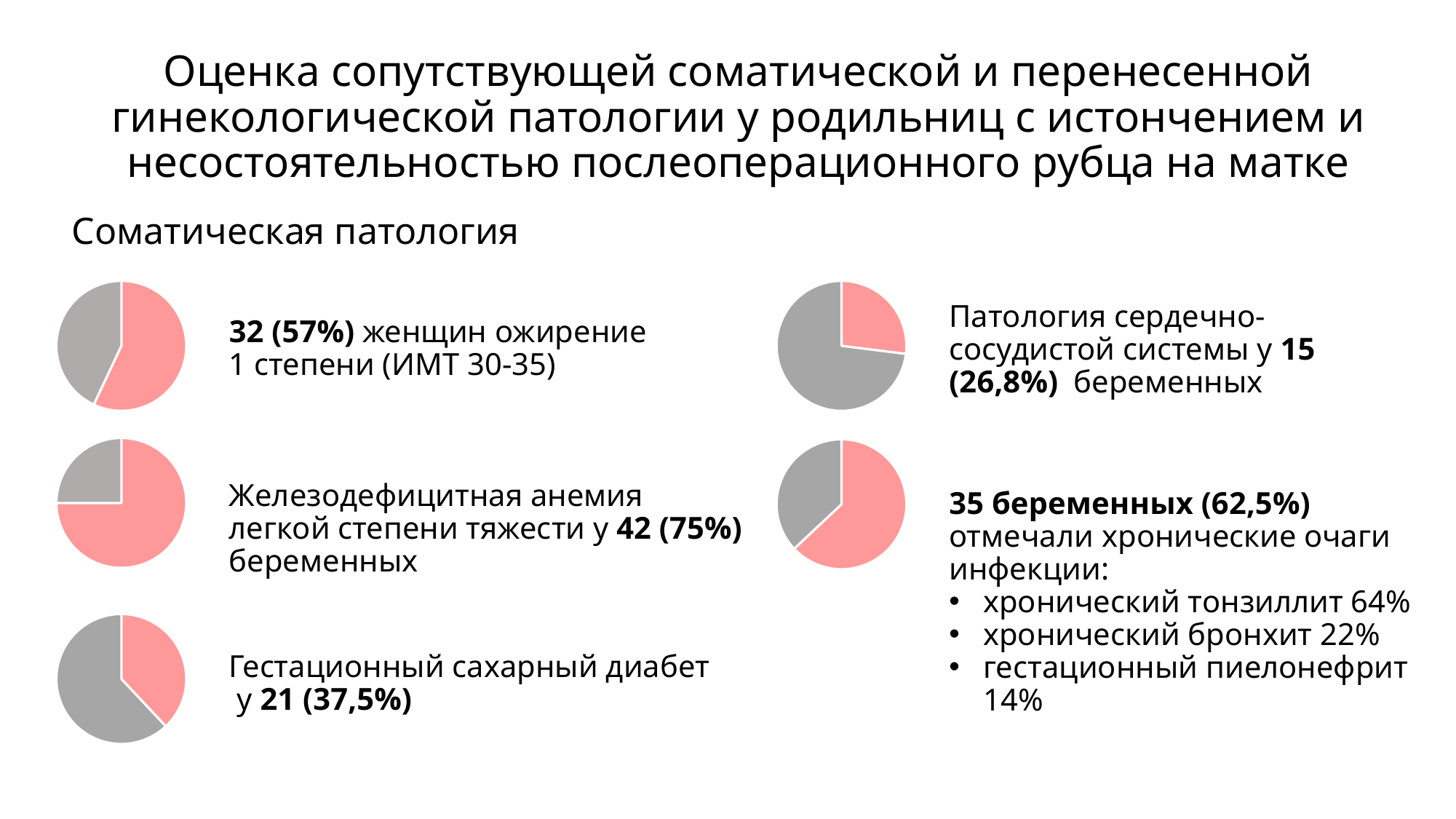
What kind of charts are shown on the slide next to the somatic pathology text? Pie charts Which of the five pie charts has the largest pink slice? Iron deficiency anemia (42, 75%) Which of the five pie charts has the smallest pink slice? Cardiovascular system pathology (15, 26,8%) In the pie chart for chronic foci of infection, what share does the pink slice represent? 62,5% How many pie charts are on the slide? 5 In the pie chart for gestational diabetes, what share does the pink slice represent? 37,5% Which pink slice is larger: the one for gestational diabetes or the one for chronic foci of infection? Chronic foci of infection In the pie chart for obesity of the 1st degree (ИМТ 30-35), what share does the pink slice represent? 57% How many pregnant women had iron deficiency anemia of mild severity, according to the text next to the middle-left pie chart? 42 How many pregnant women had cardiovascular system pathology, according to the text next to the top-right pie chart? 15